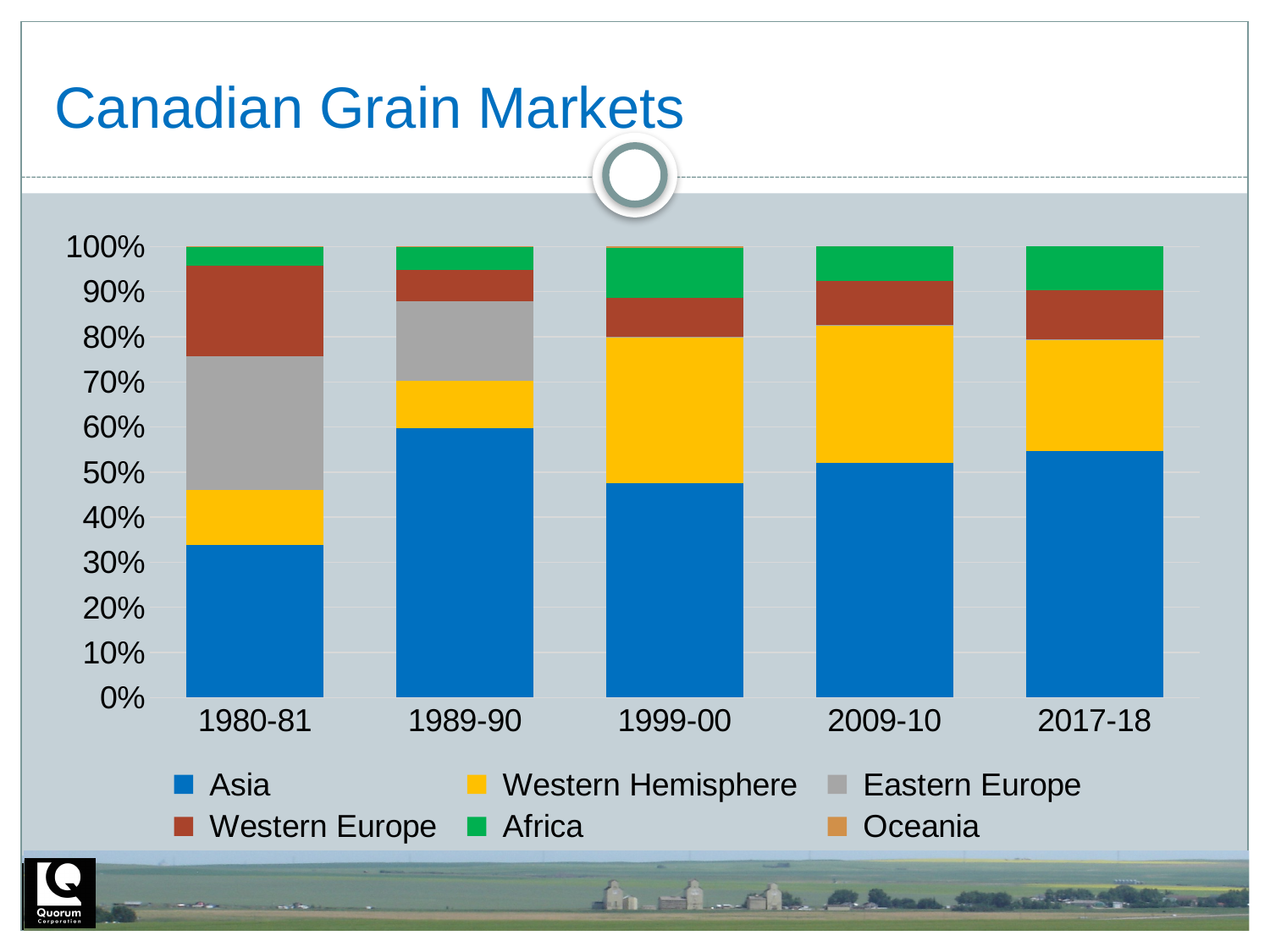
In which crop year is the Asia share the lowest? 1980-81 What is the title of the slide containing the chart? Canadian Grain Markets What is the total of the stacked bar for 2017-18? 100% In which crop year is the Asia share the highest? 1989-90 How many crop-year categories are shown on the x axis? 5 Which crop year has the larger Western Hemisphere share, 1980-81 or 1999-00? 1999-00 How many series does the legend list? 6 Which series is shown in blue in the legend? Asia What kind of chart is shown on the slide? stacked bar chart Is the Asia share for 1989-90 greater or less than 50%? greater Is the Asia share for 1999-00 greater or less than 50%? less Is the Asia share for 1980-81 greater or less than 40%? less